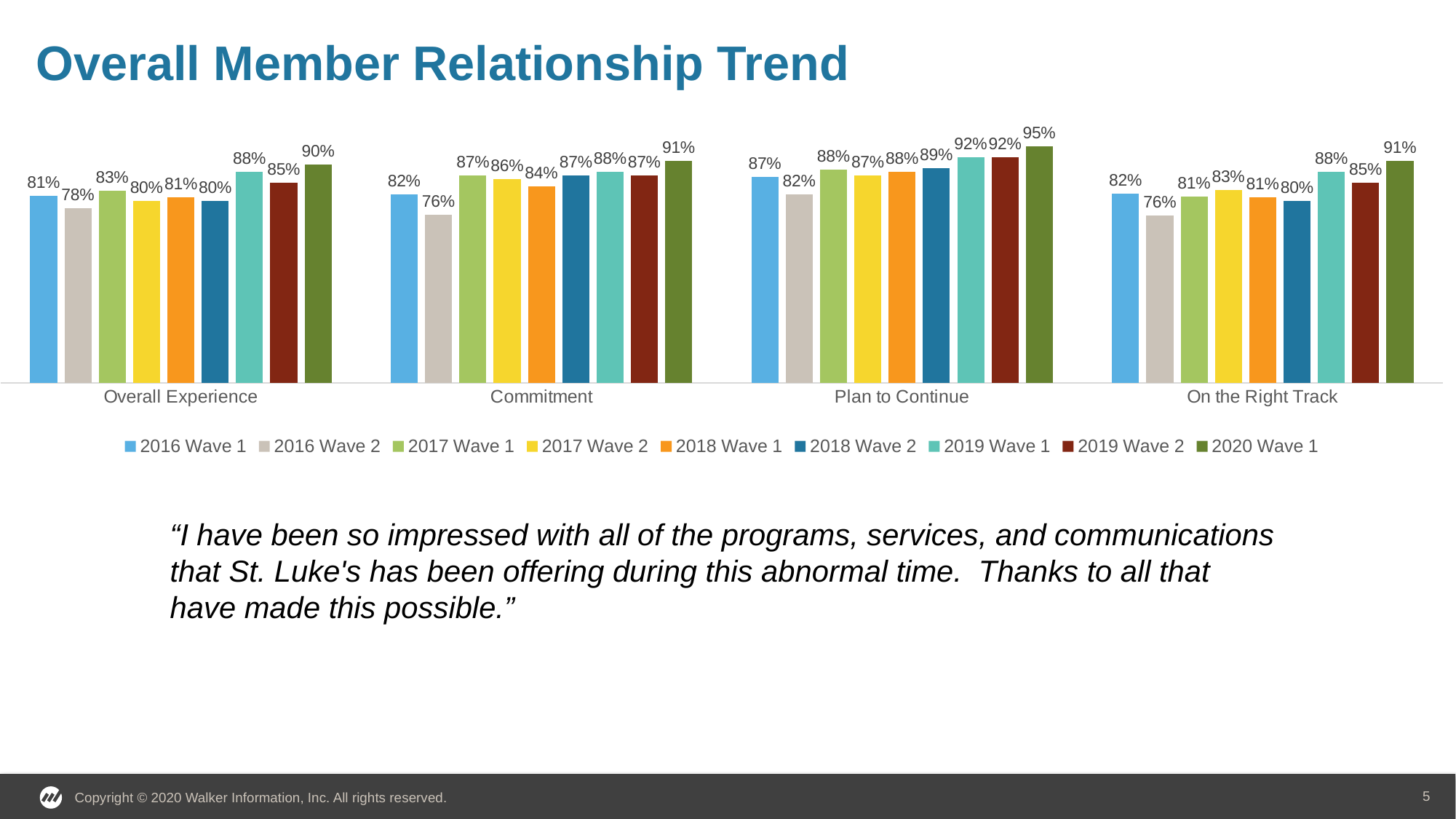
What is the value for 2018 Wave 2 in the On the Right Track category? 80% Which is larger in the Plan to Continue category: 2016 Wave 1 or 2019 Wave 2? 2019 Wave 2 Which series has the lowest value in the On the Right Track category? 2016 Wave 2 What is the value for 2019 Wave 1 in the Overall Experience category? 88% What is the difference between the 2020 Wave 1 and 2016 Wave 1 values in the Overall Experience category? 9% How many categories are shown on the x axis? 4 What is the title of the slide containing the chart? Overall Member Relationship Trend What is the value for 2016 Wave 2 in the Commitment category? 76% What kind of chart is shown on the slide? Bar chart How many series does the legend list? 9 Which series has the highest value in the Commitment category? 2020 Wave 1 What is the value for 2020 Wave 1 in the Plan to Continue category? 95%